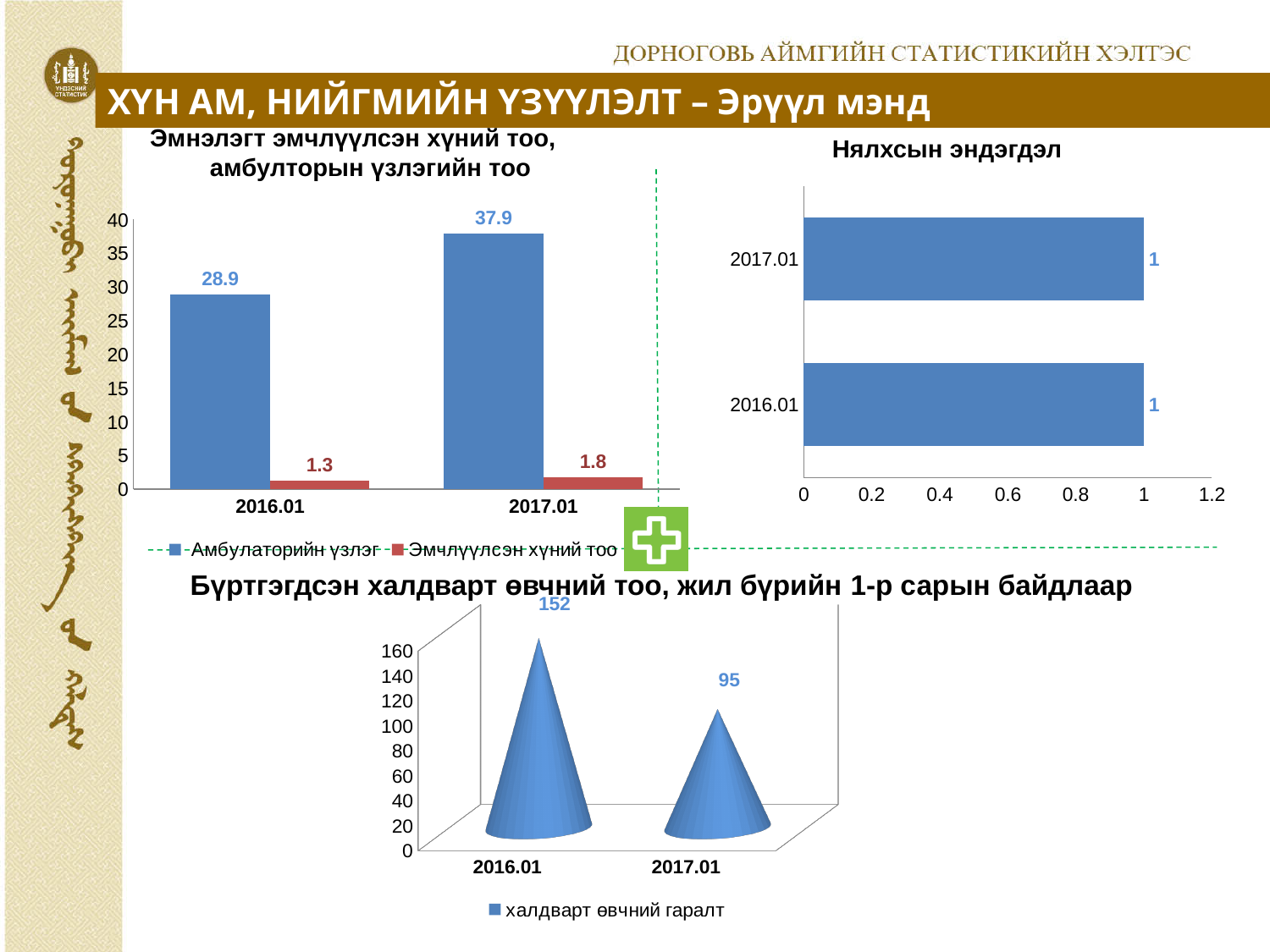
What kind of chart is the one titled Нялхсын эндэгдэл? bar chart In the bottom chart, which year has the lowest value? 2017.01 In the top-left chart, what is the value of Амбулаторийн үзлэг for 2017.01? 37.9 In the bottom chart, what is the difference between the values for 2016.01 and 2017.01? 57 In the top-left chart, what is the difference between the Амбулаторийн үзлэг values for 2017.01 and 2016.01? 9 How many series does the legend of the top-left chart list? 2 In the top-left chart, what is the value of Эмчлүүлсэн хүний тоо for 2016.01? 1.3 In the chart titled Нялхсын эндэгдэл, what is the value for 2016.01? 1 In the top-left chart, does the Амбулаторийн үзлэг value rise or fall from 2016.01 to 2017.01? rise In the top-left chart, which year has the higher Эмчлүүлсэн хүний тоо value, 2016.01 or 2017.01? 2017.01 In the bottom chart, what is the value for 2016.01? 152 How many categories are shown in the chart titled Нялхсын эндэгдэл? 2